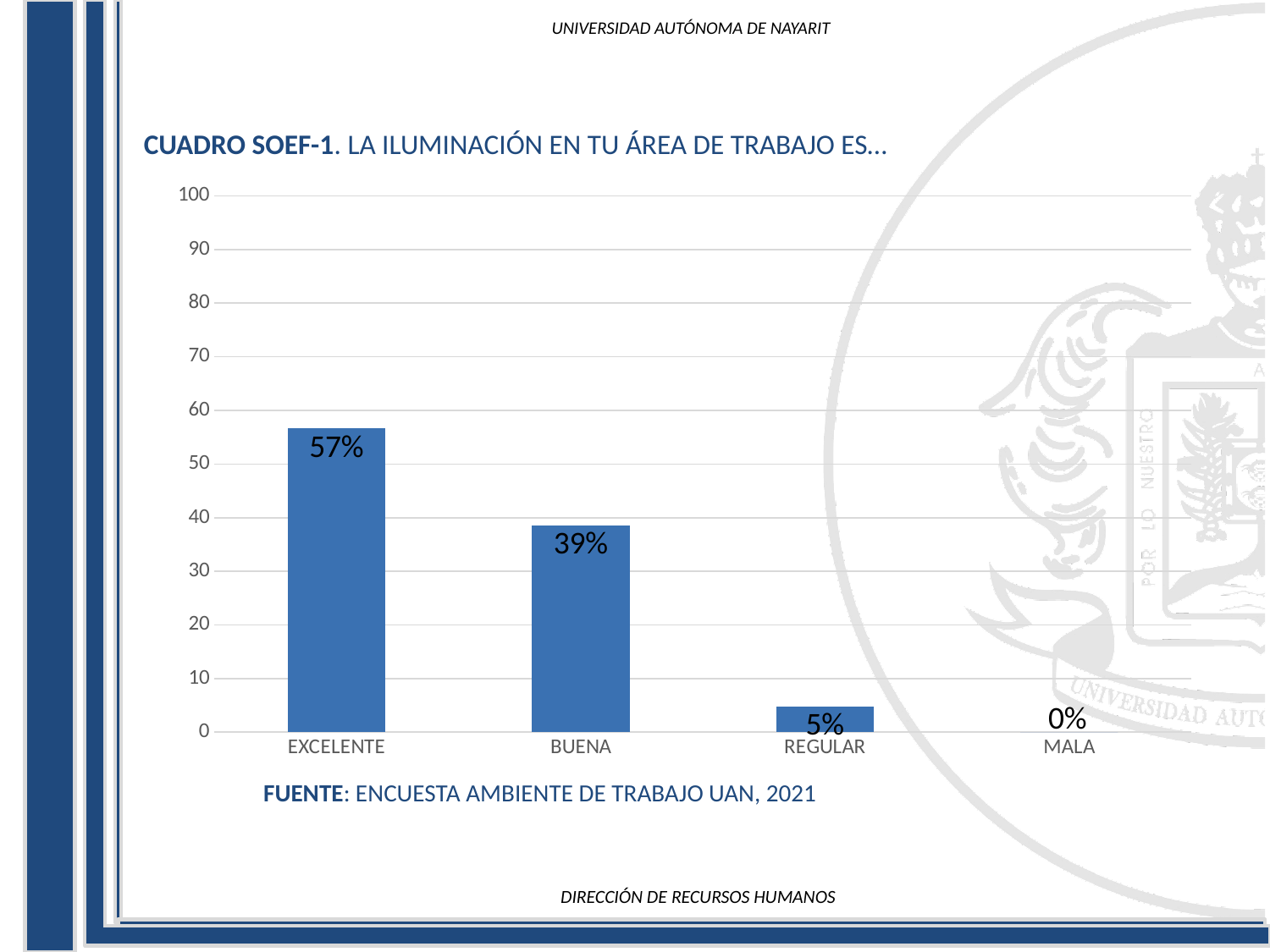
What is the value for MALA? 0% What kind of chart is shown on the slide? bar chart What is the value for EXCELENTE? 57% Which is larger, the value for BUENA or the value for REGULAR? BUENA Is the value for EXCELENTE greater or less than 50? greater Which category has the highest value? EXCELENTE How many categories are shown on the x axis? 4 Do the values rise or fall from left to right along the x axis? fall Which category has the lowest value? MALA What is the difference between the values for EXCELENTE and BUENA? 18% What is the value for BUENA? 39% What is the value for REGULAR? 5%